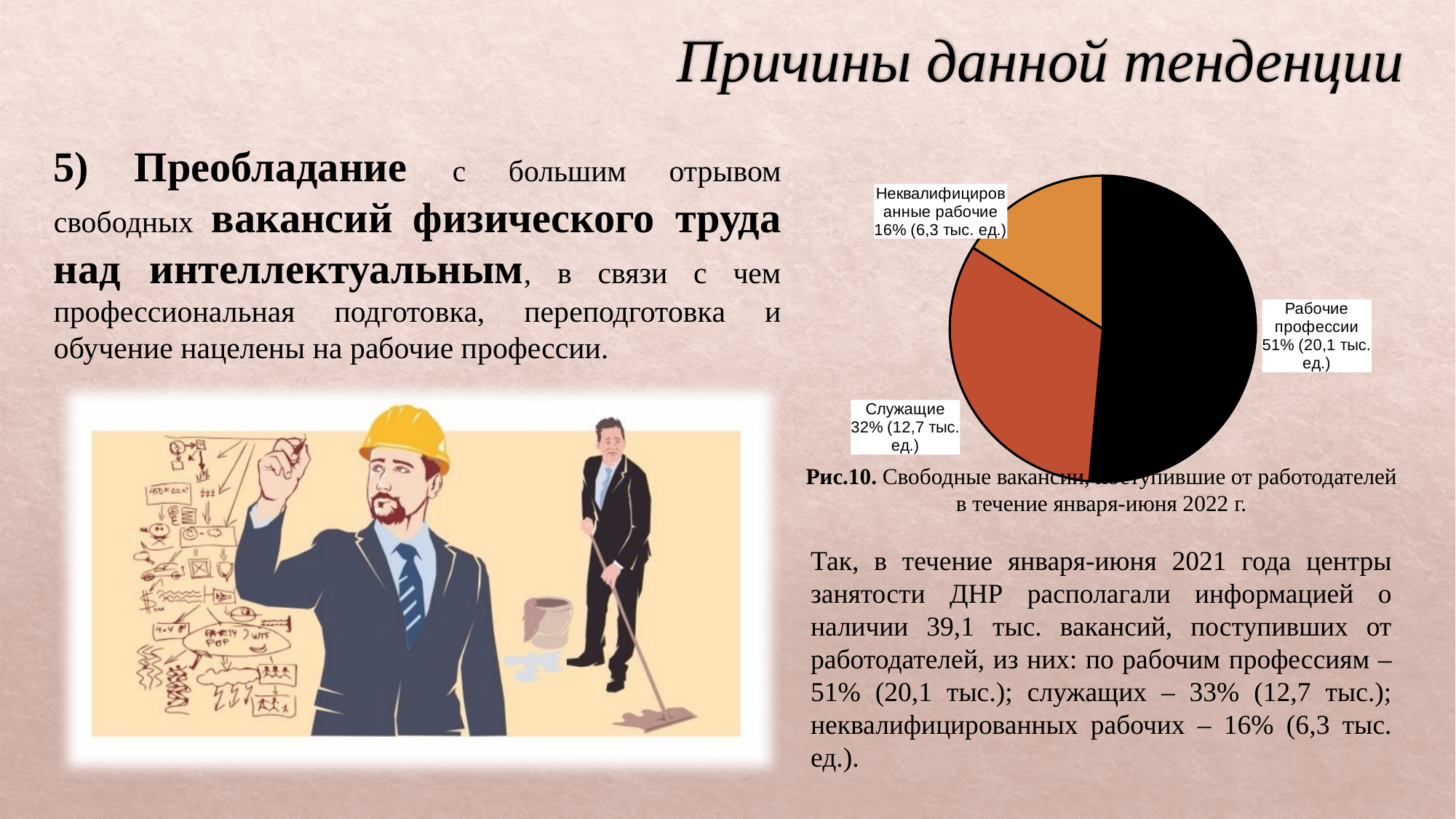
What share of the pie does the slice "Неквалифицированные рабочие" represent? 16% What kind of chart is shown on the slide? Pie chart What is the difference in percentage points between the "Рабочие профессии" and "Служащие" slices? 19 How many slices does the pie chart have? 3 What value in thousands of units is shown for "Рабочие профессии"? 20,1 тыс. ед. What share of the pie does the slice "Служащие" represent? 32% Which category has the largest slice of the pie? Рабочие профессии What share of the pie does the slice "Рабочие профессии" represent? 51% Which slice is larger: "Служащие" or "Неквалифицированные рабочие"? Служащие What value in thousands of units is shown for "Неквалифицированные рабочие"? 6,3 тыс. ед. What value in thousands of units is shown for "Служащие"? 12,7 тыс. ед. Which category has the smallest slice of the pie? Неквалифицированные рабочие